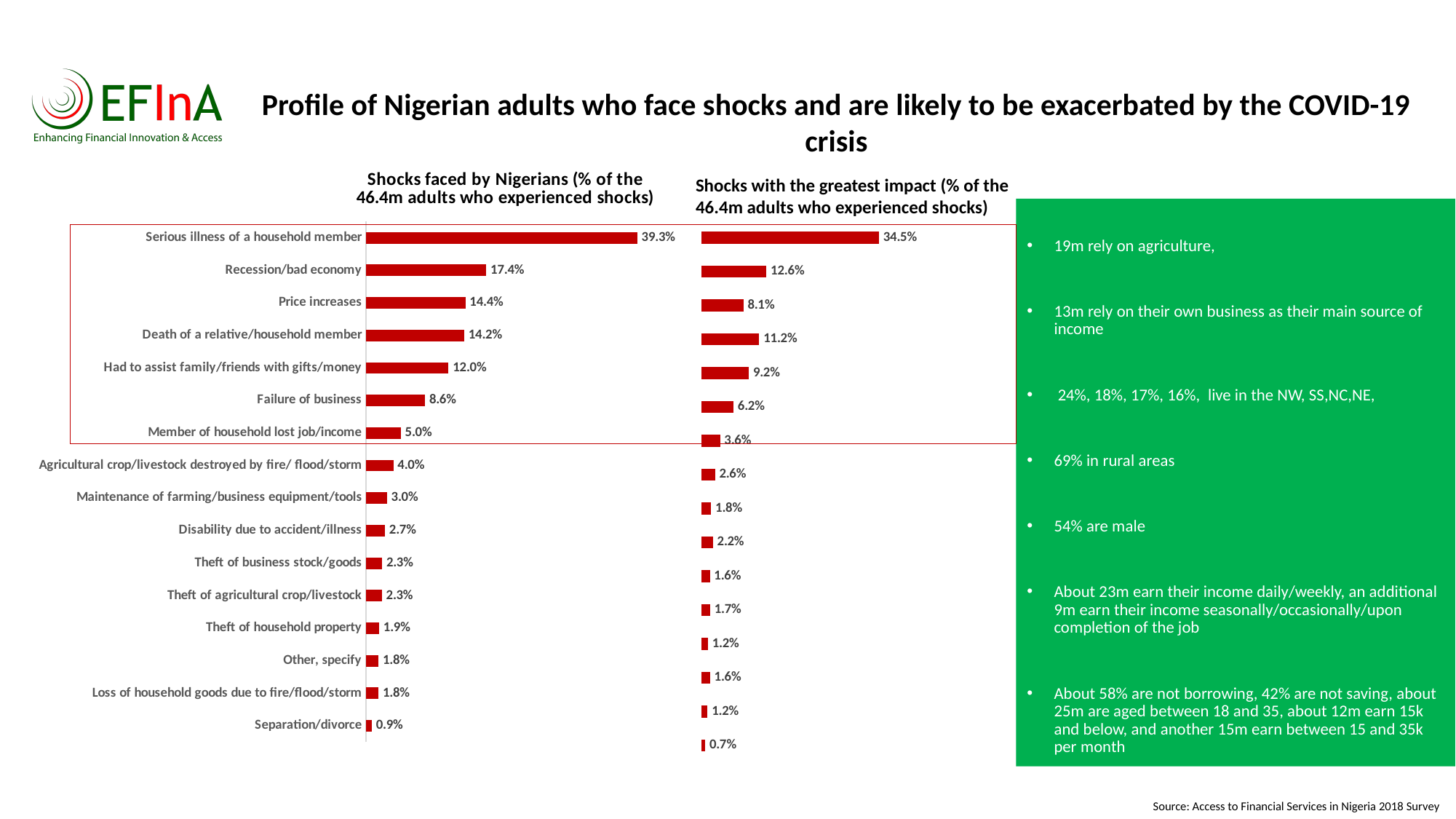
In the 'Shocks faced by Nigerians' chart, what percentage is shown for Failure of business? 8.6% In the 'Shocks with the greatest impact' chart, what percentage is shown for Recession/bad economy? 12.6% What colour are the bars in the 'Shocks with the greatest impact' chart? Red In the 'Shocks faced by Nigerians' chart, which category has the lowest value? Separation/divorce In the 'Shocks faced by Nigerians' chart, which is larger: Had to assist family/friends with gifts/money or Failure of business? Had to assist family/friends with gifts/money In the 'Shocks faced by Nigerians' chart, what percentage is shown for Serious illness of a household member? 39.3% In the 'Shocks with the greatest impact' chart, what is the difference between Serious illness of a household member and Recession/bad economy? 21.9% What type of chart is the 'Shocks faced by Nigerians' chart? Bar chart How many categories are shown in the 'Shocks faced by Nigerians' chart? 16 In the 'Shocks faced by Nigerians' chart, which category has the highest value? Serious illness of a household member In the 'Shocks faced by Nigerians' chart, what is the difference between Recession/bad economy and Price increases? 3.0% In the 'Shocks with the greatest impact' chart, what percentage is shown for Serious illness of a household member? 34.5%